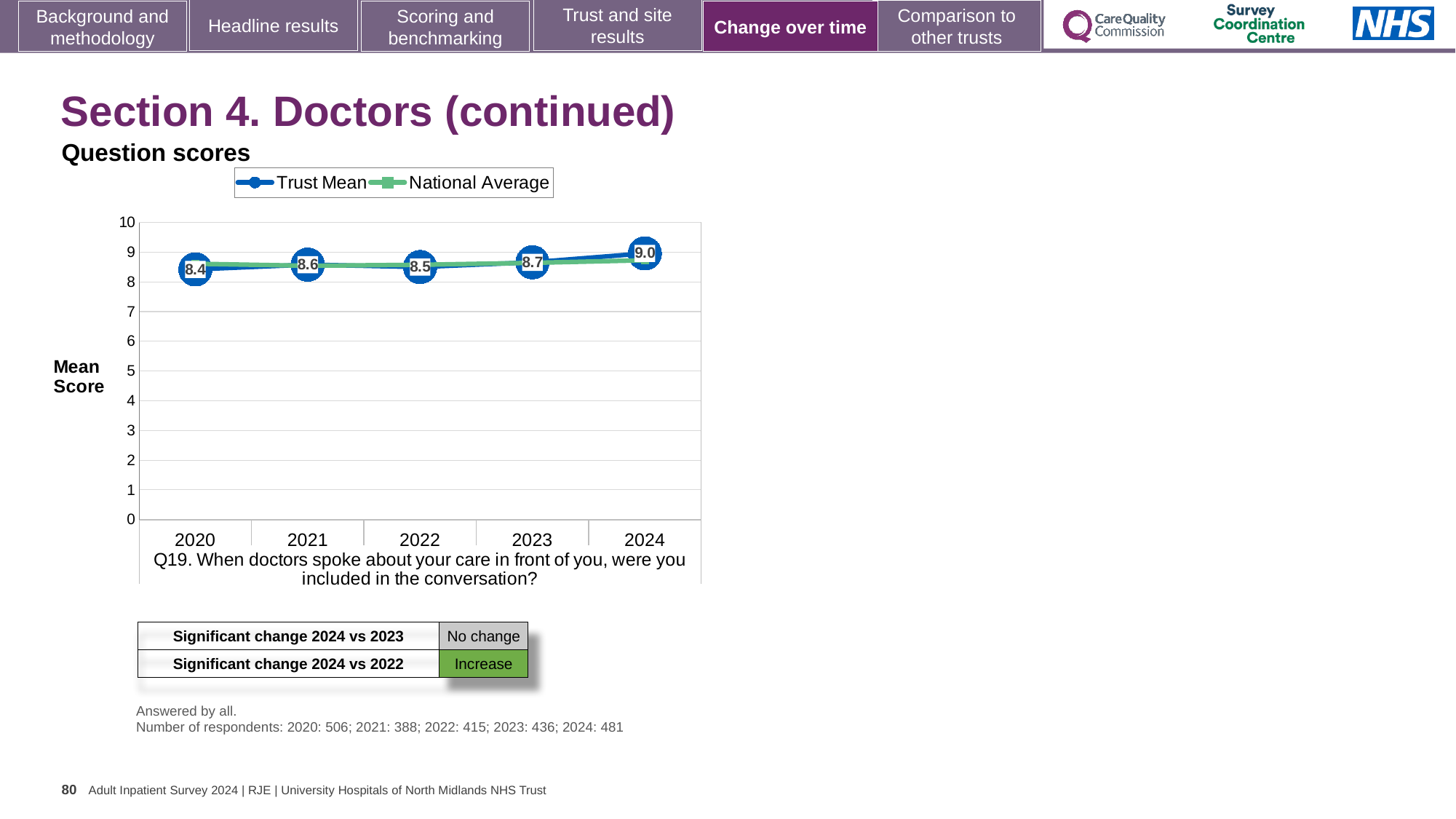
In which year is the Trust Mean score lowest? 2020 Which year has the larger Trust Mean score, 2021 or 2022? 2021 Is the National Average value for 2024 greater or less than 8? greater What is the Trust Mean score for 2024? 9.0 How many years are plotted on the x axis? 5 How many series does the legend list? 2 What is the Trust Mean score for 2020? 8.4 What is the difference between the Trust Mean scores for 2024 and 2020? 0.6 What kind of chart is shown on the slide? Line chart Does the Trust Mean score rise or fall overall from 2020 to 2024? Rise In which year is the Trust Mean score highest? 2024 What is the Trust Mean score for 2022? 8.5